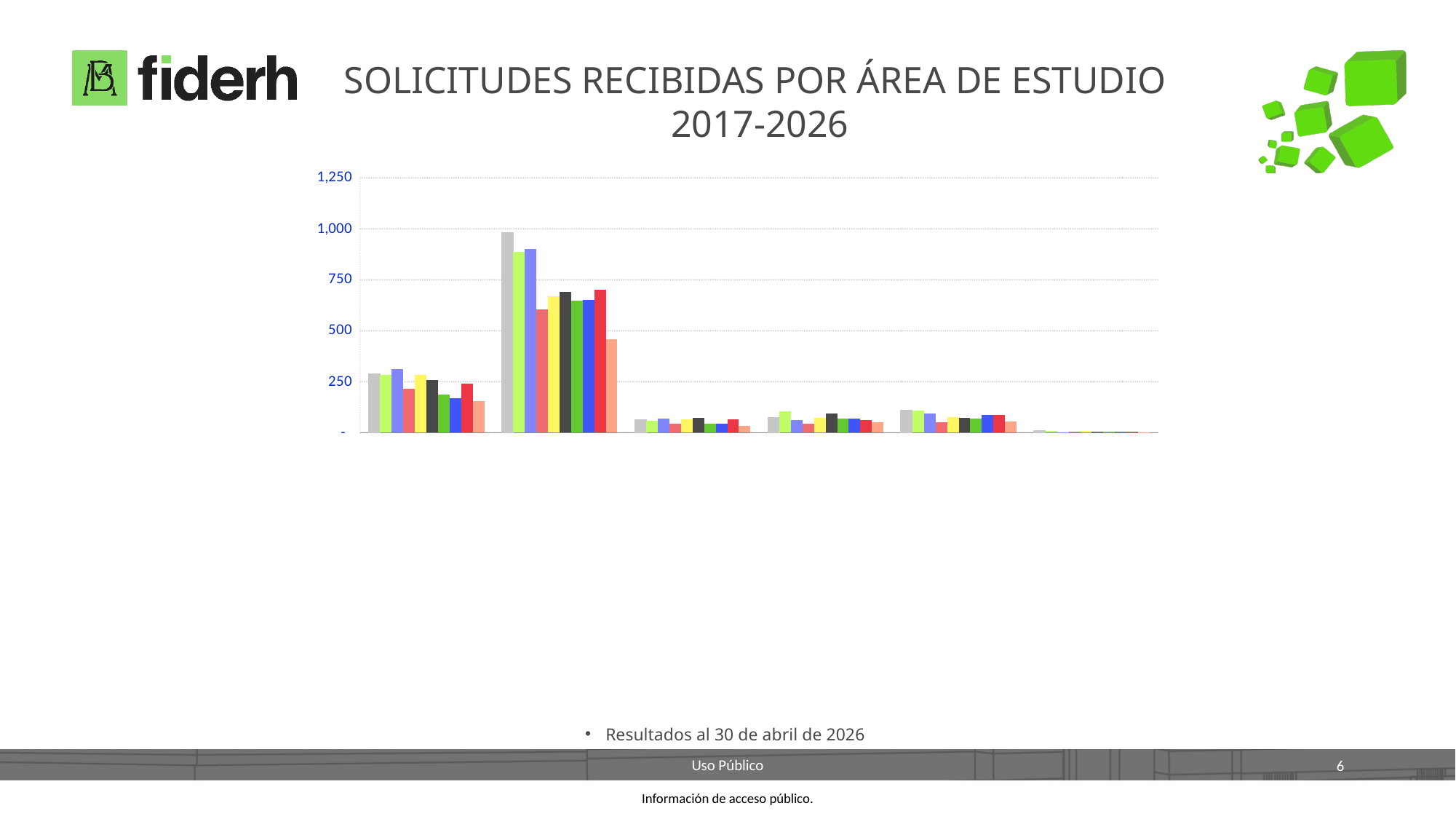
How many bars are there in each group on the chart? 10 Is the tallest bar in the second group from the left larger or smaller than the tallest bar in the first group? larger Is the tallest bar in the first group from the left greater or less than 500? less Which group of bars, counted from the left, has the smallest values on the chart? the sixth group Is the tallest bar in the third group from the left greater or less than 250? less What is the title of the chart on the slide? SOLICITUDES RECIBIDAS POR ÁREA DE ESTUDIO 2017-2026 What is the highest value shown on the vertical axis of the chart? 1,250 Which group of bars, counted from the left, contains the tallest bar on the chart? the second group What kind of chart is shown on the slide? bar chart Is the tallest bar in the second group from the left greater or less than 750? greater How many groups of bars are plotted on the chart? 6